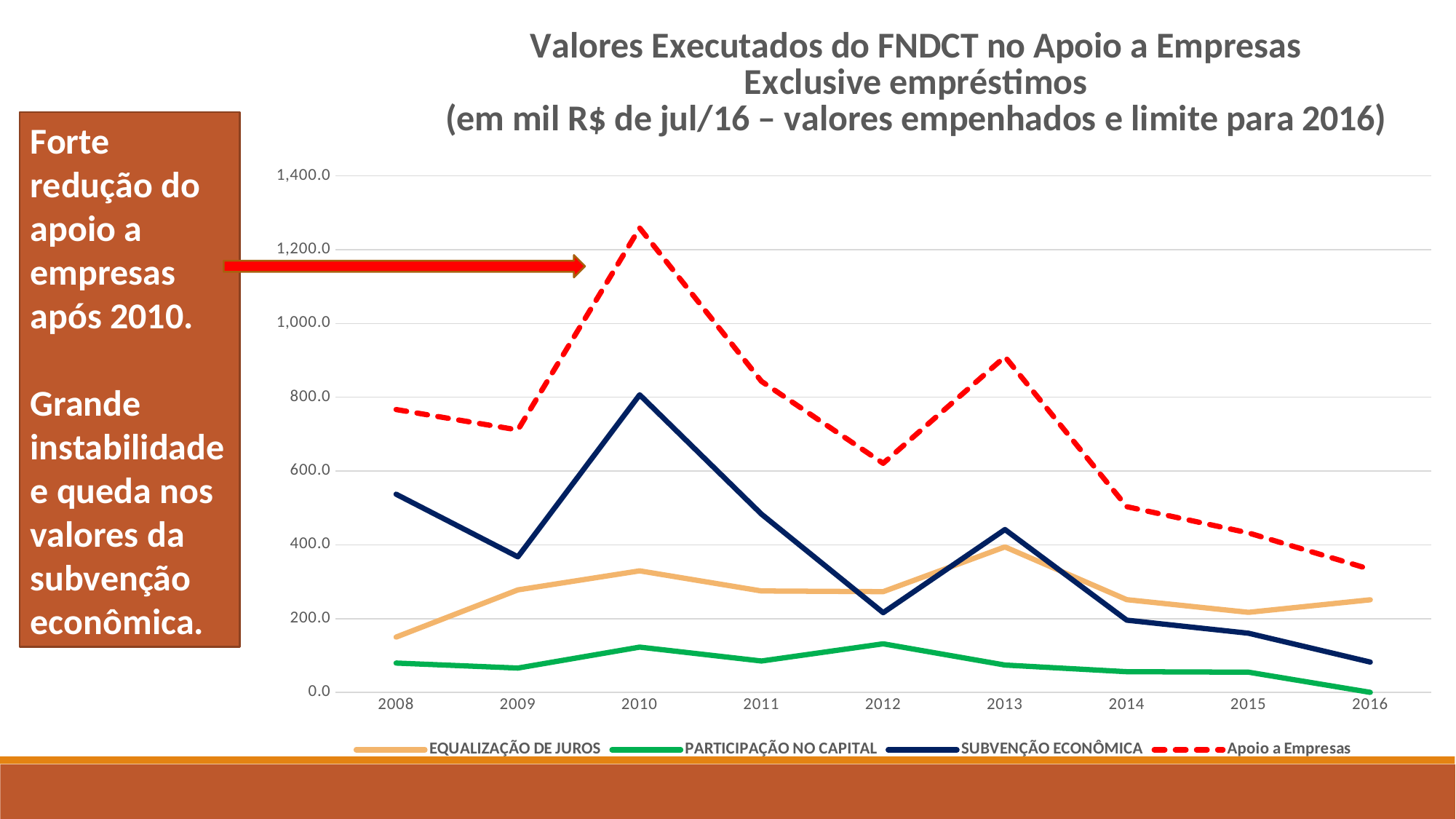
In which year does the Apoio a Empresas series reach its highest value? 2010 Is the value for EQUALIZAÇÃO DE JUROS in 2008 greater or less than 200.0? less Is the value for Apoio a Empresas in 2016 greater or less than 400.0? less Is the value for Apoio a Empresas in 2010 greater or less than 1,200.0? greater In which year does the SUBVENÇÃO ECONÔMICA series reach its highest value? 2010 How many years are plotted along the x axis? 9 In 2012, which is larger: EQUALIZAÇÃO DE JUROS or SUBVENÇÃO ECONÔMICA? EQUALIZAÇÃO DE JUROS What kind of chart is shown on the slide? line chart How many series does the legend list? 4 In which year is the PARTICIPAÇÃO NO CAPITAL series at its lowest? 2016 In which year does the EQUALIZAÇÃO DE JUROS series reach its highest value? 2013 Does the Apoio a Empresas series rise or fall from 2013 to 2016? fall